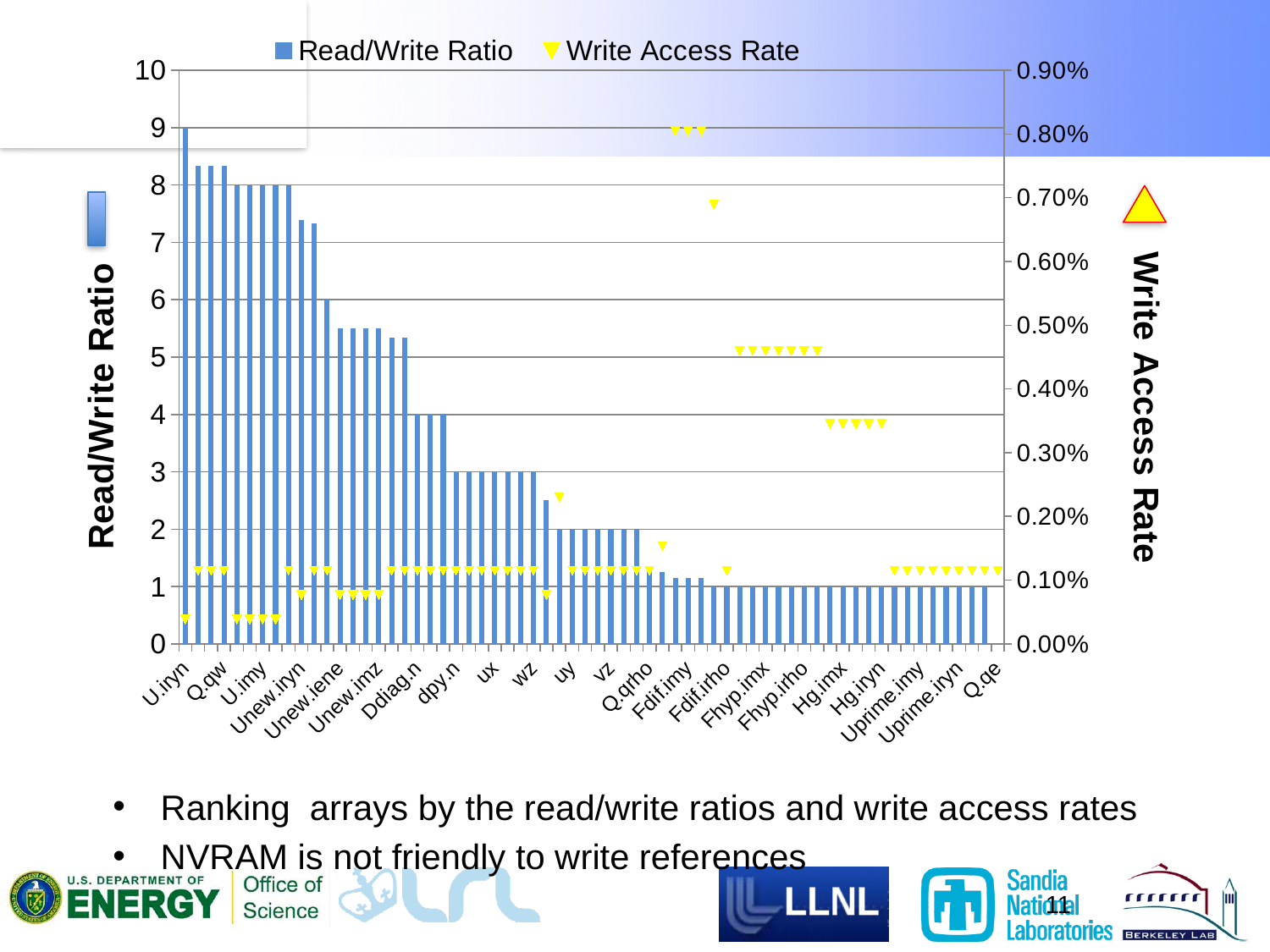
Is the Write Access Rate for U.iryn greater or less than 0.10%? less What is the Read/Write Ratio for Q.qe? 0 Which array has the highest Read/Write Ratio? U.iryn Is the Read/Write Ratio for U.iryn greater or less than 5? greater What are the two series named in the chart legend? Read/Write Ratio and Write Access Rate Do the Read/Write Ratio bars rise or fall from left to right across the x axis? fall Is the Read/Write Ratio for Q.qe greater or less than 2? less Which series is plotted with yellow triangle markers? Write Access Rate What kind of chart is shown on the slide? bar chart (with a secondary marker series) Which has the larger Read/Write Ratio, U.iryn or Q.qe? U.iryn How many series does the chart legend list? 2 What is the Read/Write Ratio for U.iryn? 9